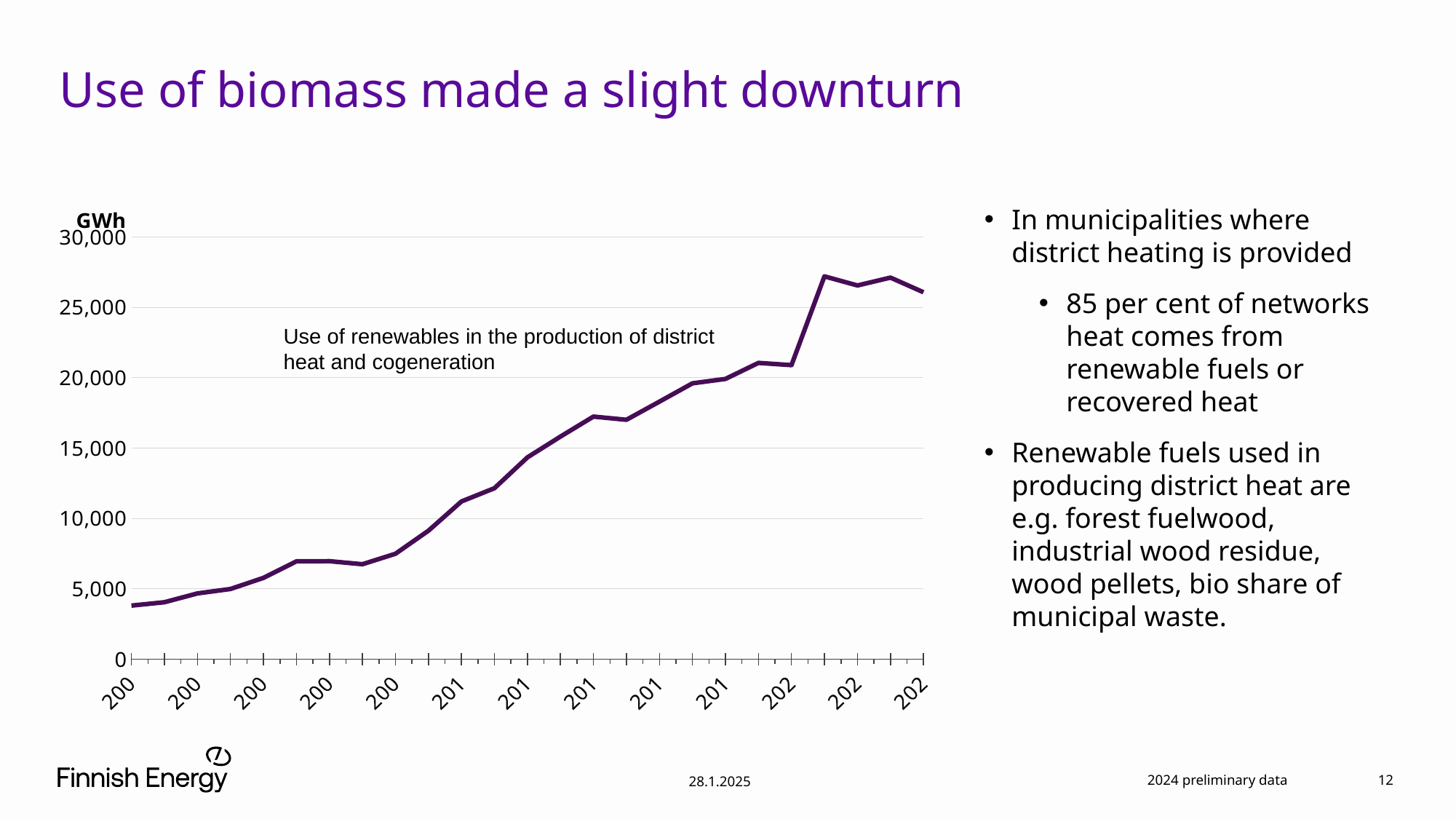
Is the value at the rightmost point of the line greater or less than 20,000? greater What unit is shown on the y axis of the chart? GWh What kind of chart is shown on the slide? Line chart How many series are plotted on the chart? 1 Is the lowest value of the line at the left end or the right end of the x axis? left end Does the line reach its highest value at the last (rightmost) point? No Is the value at the leftmost point of the line greater or less than 5,000? less Overall, does the line rise or fall from left to right along the x axis? Rises Is the rightmost point of the line higher or lower than the peak of the line? lower Does the line ever exceed 30,000 on the y axis? No What text label is printed inside the chart area describing the data? Use of renewables in the production of district heat and cogeneration